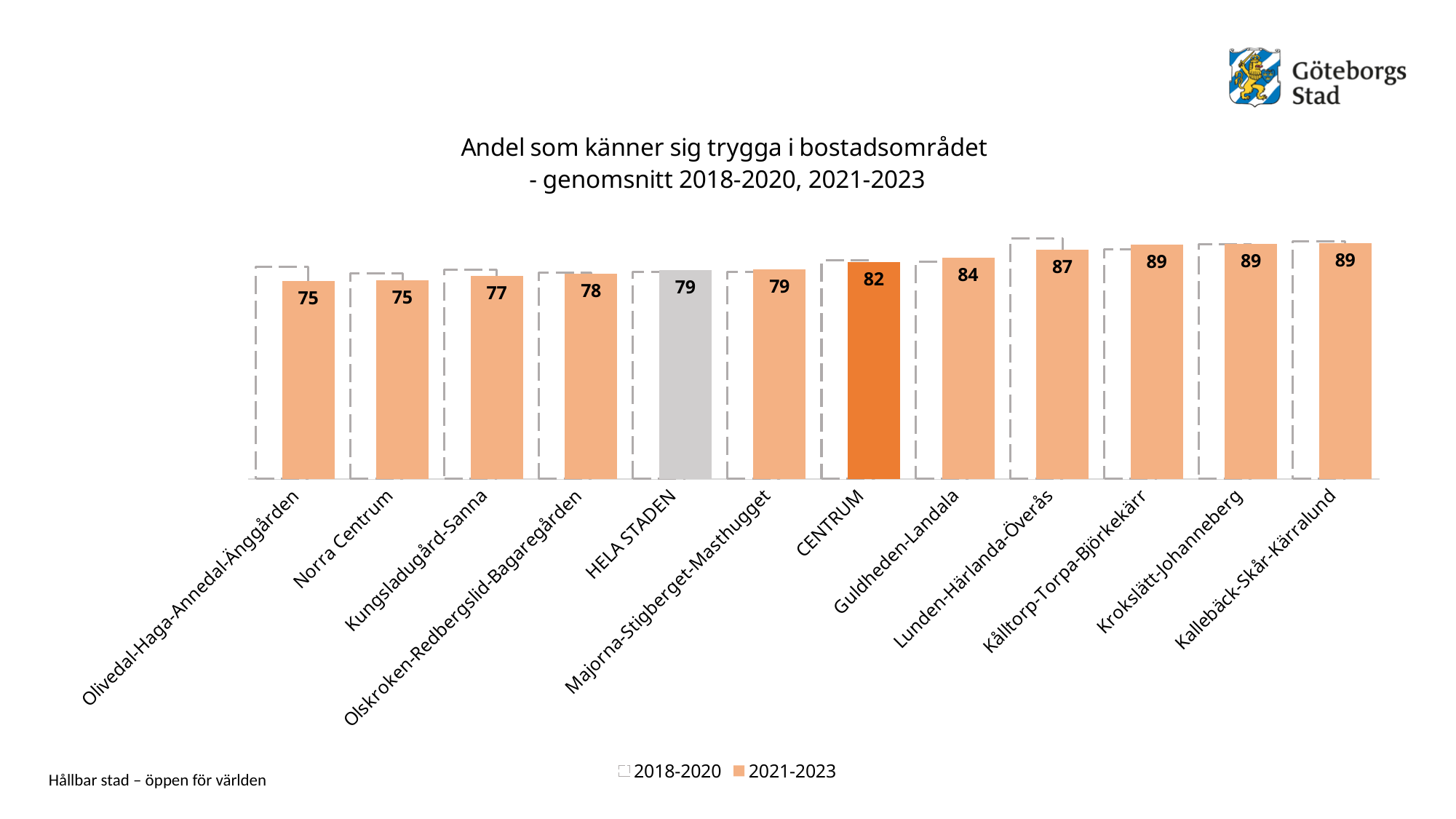
What is the difference between the 2021-2023 values for Kallebäck-Skår-Kärralund and Olivedal-Haga-Annedal-Änggården? 14 How many series does the legend list? 2 How many categories are shown on the x axis? 12 Is the 2021-2023 value for Guldheden-Landala larger or smaller than the value for Majorna-Stigberget-Masthugget? larger What is the 2021-2023 value for Lunden-Härlanda-Överås? 87 What is the 2021-2023 value for HELA STADEN? 79 What kind of chart is shown on the slide? bar chart Do the 2021-2023 values rise or fall from left to right along the x axis? rise What is the difference between the 2021-2023 values for CENTRUM and HELA STADEN? 3 What is the 2021-2023 value for Guldheden-Landala? 84 What is the 2021-2023 value for CENTRUM? 82 Which category has the lowest 2021-2023 value, Olivedal-Haga-Annedal-Änggården or Kungsladugård-Sanna? Olivedal-Haga-Annedal-Änggården